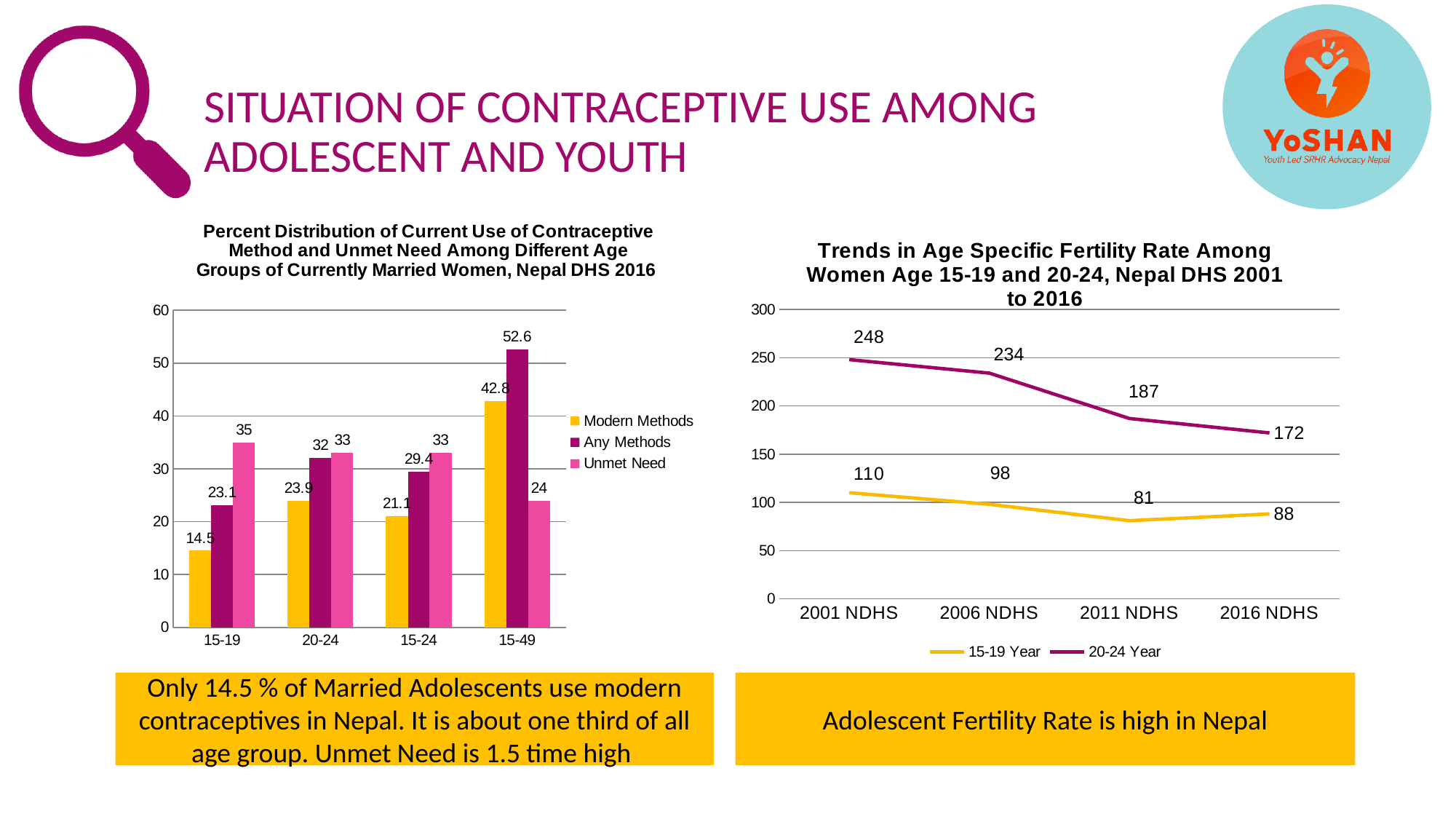
In the right chart (Trends in Age Specific Fertility Rate), what is the 20-24 Year value for 2006 NDHS? 234 In the right chart, does the 20-24 Year series rise or fall from 2001 NDHS to 2016 NDHS? Fall What type of chart is the left chart? Bar chart In the left chart, what is the Unmet Need value for the 20-24 age group? 33 In the left chart, which age group has the highest Modern Methods value? 15-49 In the left chart, what is the Any Methods value for the 15-49 age group? 52.6 In the left chart, what is the difference between the Any Methods and Modern Methods values for the 15-24 age group? 8.3 In the right chart, what is the 15-19 Year value for 2011 NDHS? 81 In the right chart, what is the difference between the 20-24 Year values for 2001 NDHS and 2016 NDHS? 76 In the left chart, how many series does the legend list? 3 In the left chart (Percent Distribution of Current Use of Contraceptive Method), what is the Modern Methods value for the 15-19 age group? 14.5 In the left chart, which age group has the lowest Unmet Need value? 15-49